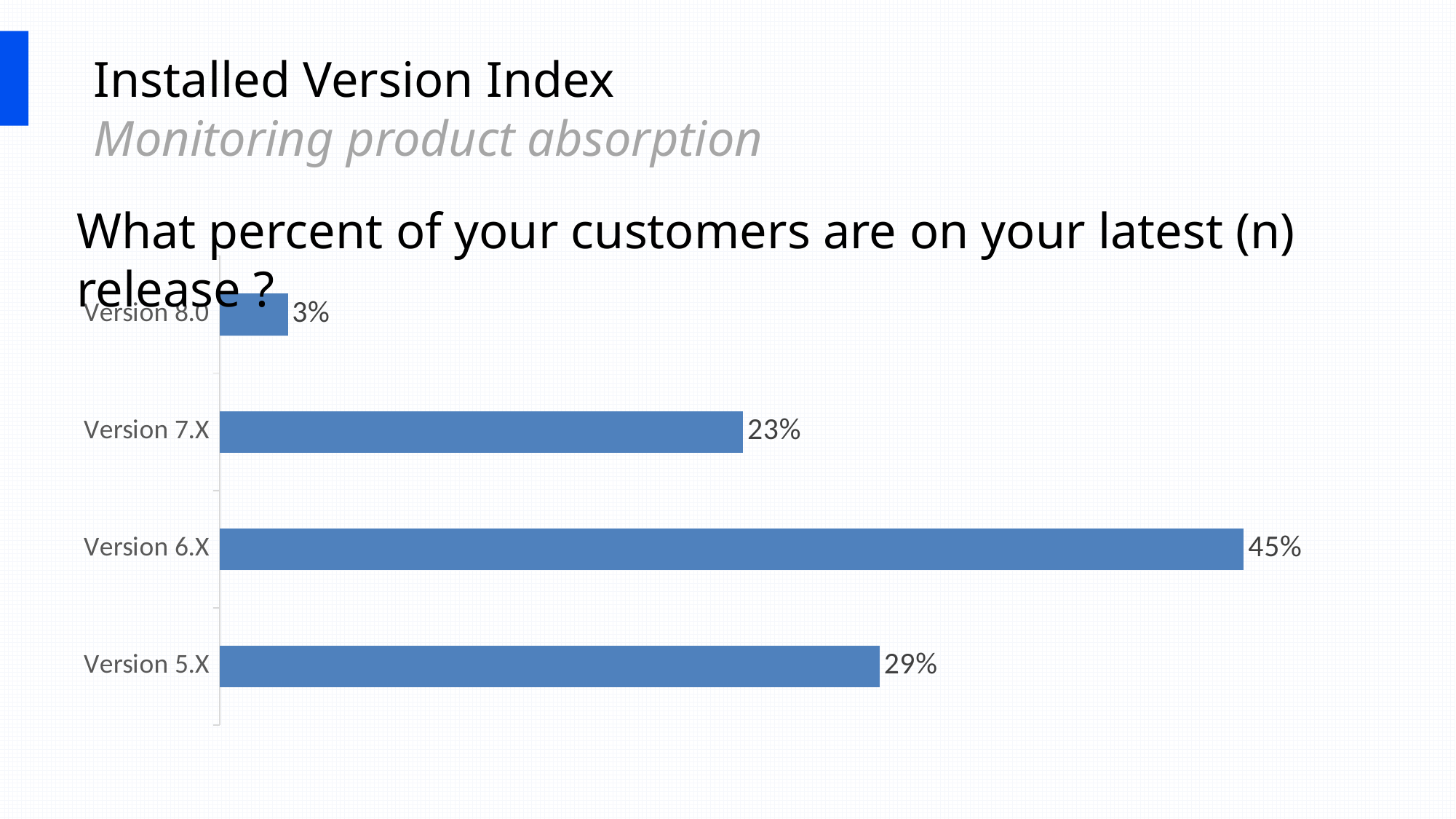
What is the value for Version 7.X? 23% What colour are the bars in the chart? Blue What is the value for Version 6.X? 45% Which version has the highest value? Version 6.X What is the difference between the values for Version 6.X and Version 5.X? 16% What kind of chart is shown on the slide? Bar chart What is the value for Version 8.0? 3% What is the value for Version 5.X? 29% What is the difference between the values for Version 7.X and Version 8.0? 20% How many versions are shown in the chart? 4 Which is larger, the value for Version 5.X or Version 7.X? Version 5.X Which version has the lowest value? Version 8.0